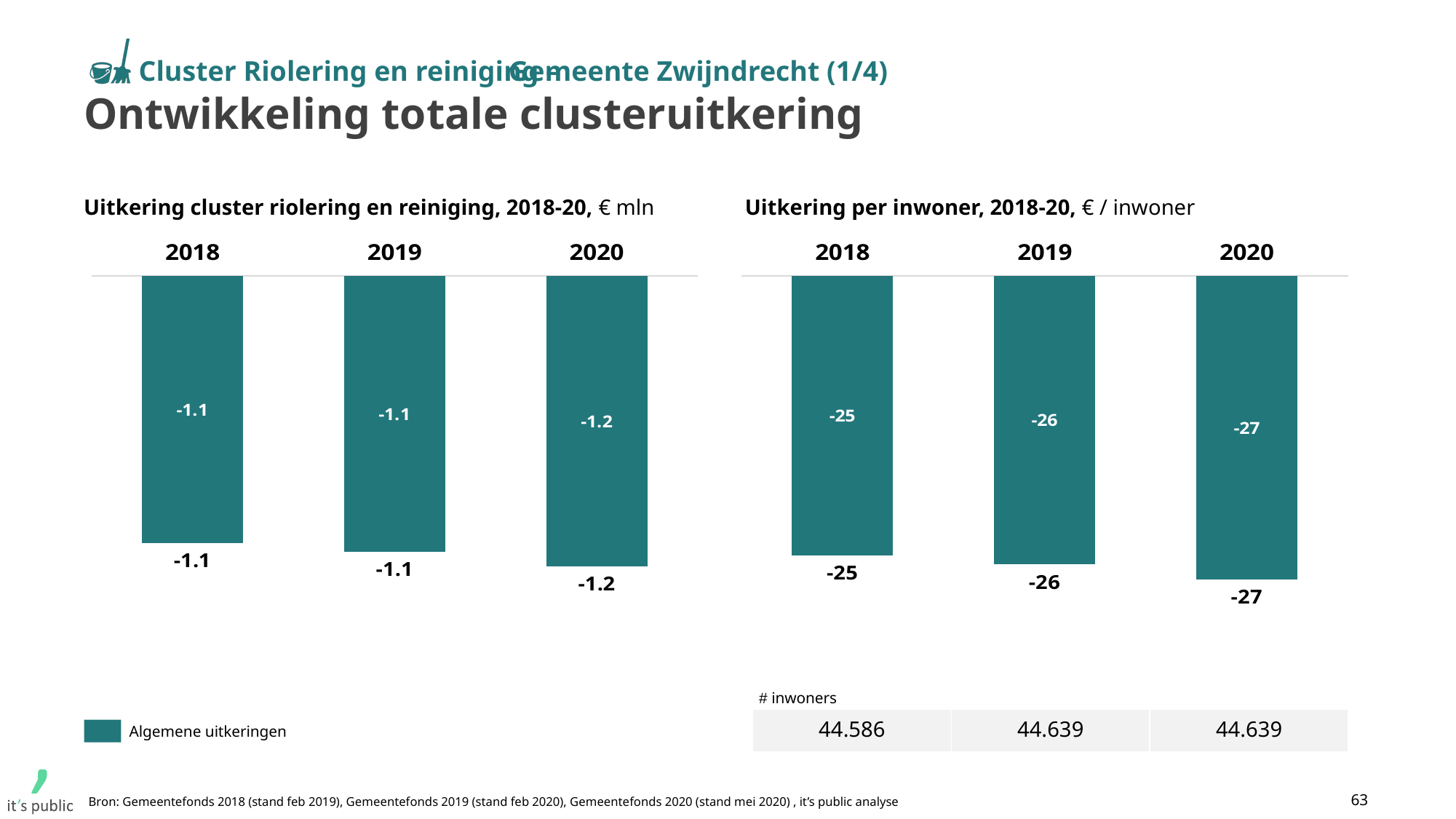
In the left chart 'Uitkering cluster riolering en reiniging, 2018-20', what is the value for 2018? -1.1 In the right chart 'Uitkering per inwoner, 2018-20', what is the difference between the 2018 value and the 2020 value? 2 In the right chart 'Uitkering per inwoner, 2018-20', which year has the lowest value? 2020 How many years are shown in the left chart 'Uitkering cluster riolering en reiniging, 2018-20'? 3 In the left chart 'Uitkering cluster riolering en reiniging, 2018-20', which year has the lowest value? 2020 What kind of chart is the right chart 'Uitkering per inwoner, 2018-20'? bar chart In the right chart 'Uitkering per inwoner, 2018-20', is the value for 2018 larger or smaller than the value for 2020? larger In the right chart 'Uitkering per inwoner, 2018-20', what is the value for 2019? -26 In the right chart 'Uitkering per inwoner, 2018-20', what is the value for 2020? -27 In the left chart 'Uitkering cluster riolering en reiniging, 2018-20', what is the value for 2020? -1.2 In the right chart 'Uitkering per inwoner, 2018-20', which year has the highest value? 2018 In the right chart 'Uitkering per inwoner, 2018-20', do the values rise or fall from 2018 to 2020? fall